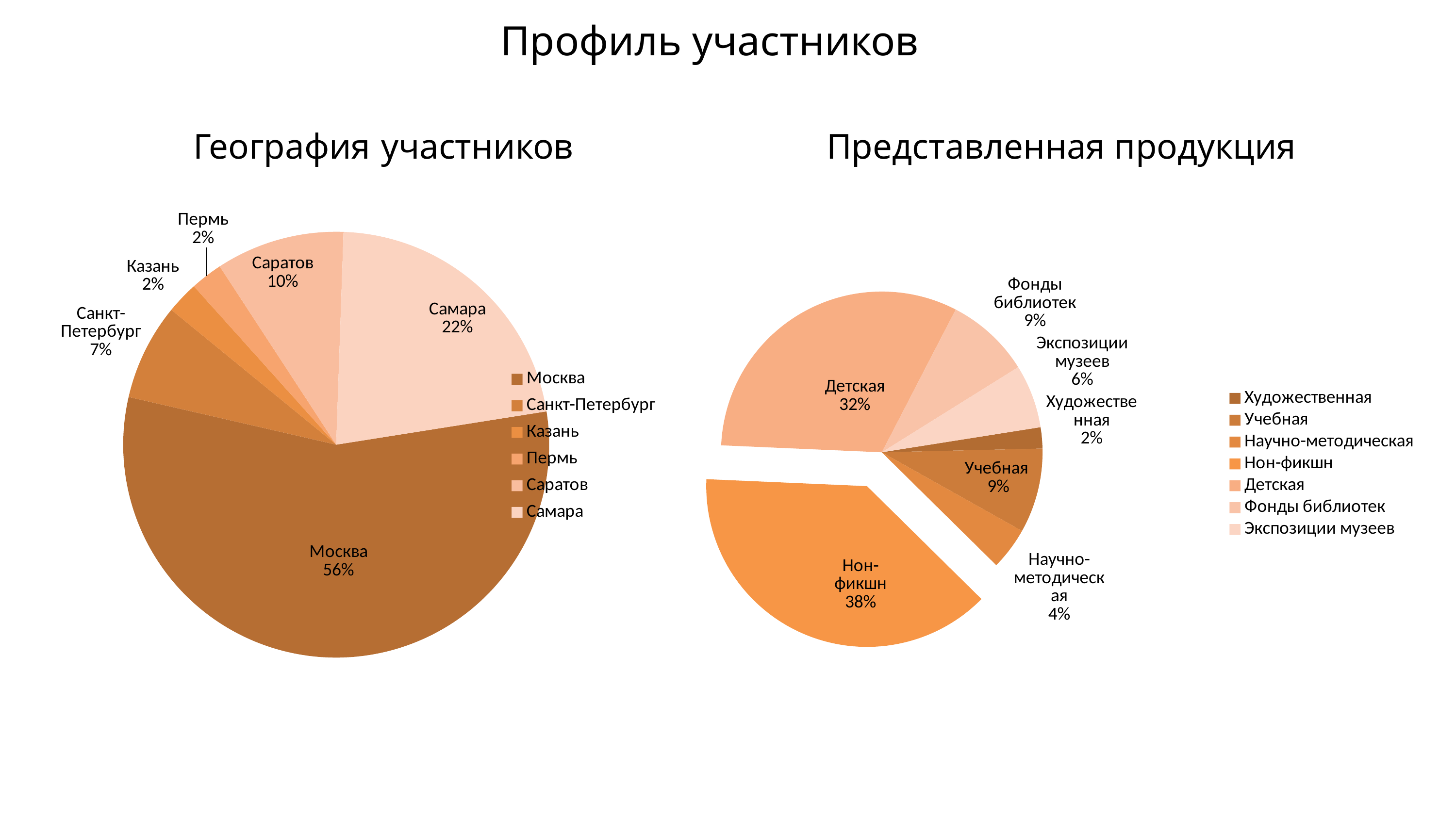
In the 'География участников' chart, what is the difference between the shares of Самара and Саратов? 12% In the 'География участников' chart, how many categories are shown? 6 What type of chart is 'География участников'? Pie chart In the 'Представленная продукция' chart, what is the difference between Нон-фикшн and Детская? 6% In the 'Представленная продукция' chart, which category has the smallest share? Художественная In the 'География участников' chart, what is the value for Самара? 22% In the 'Представленная продукция' chart, which is larger: Детская or Учебная? Детская In the 'Представленная продукция' chart, what is the value for Нон-фикшн? 38% What is the title of the slide? Профиль участников In the 'География участников' chart, which city has the largest share? Москва In the 'География участников' chart, what share does Москва have? 56% In the 'Представленная продукция' chart, how many categories does the legend list? 7